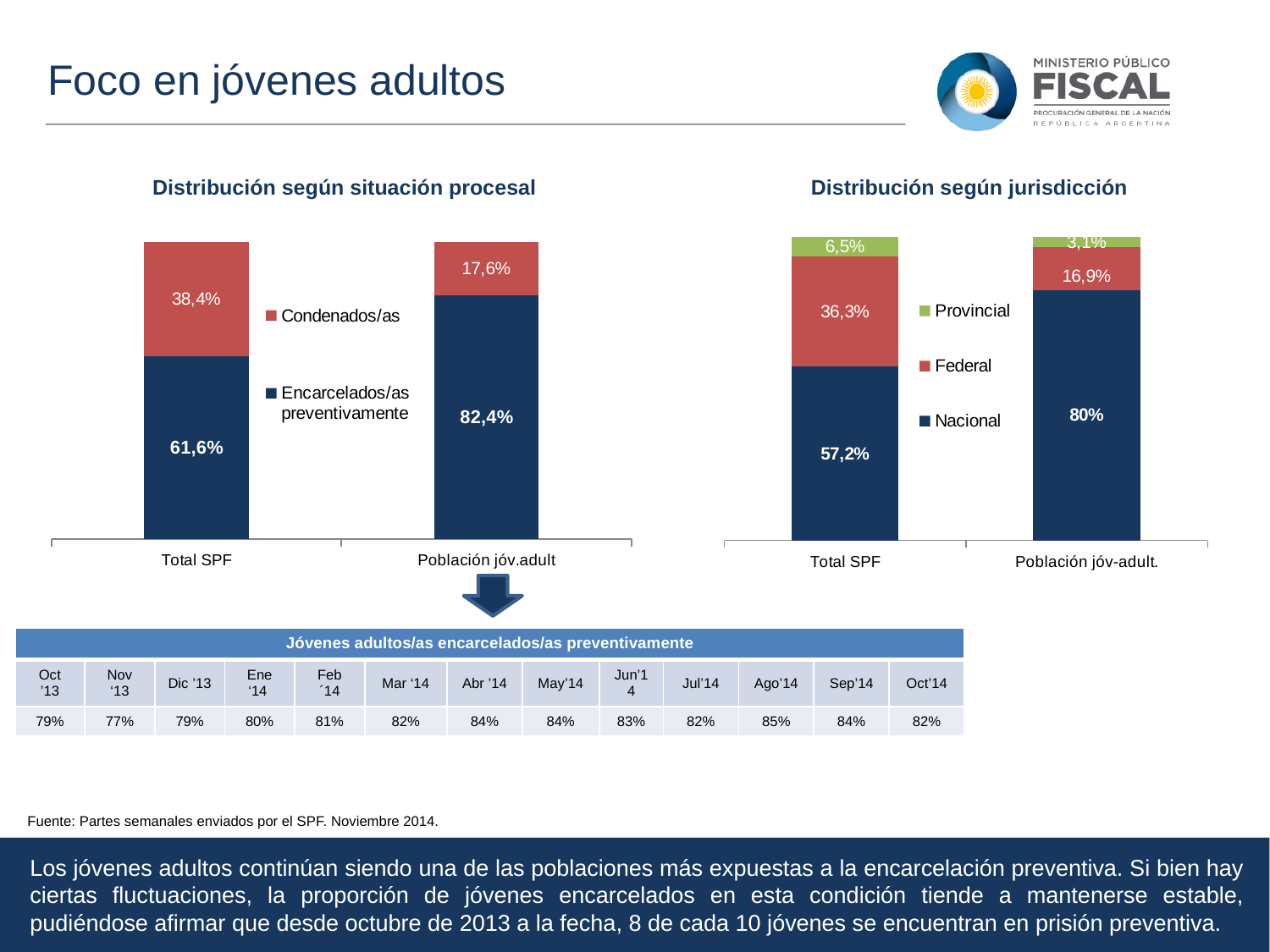
In the chart 'Distribución según situación procesal', what is the value for Encarcelados/as preventivamente in the Total SPF bar? 61,6% In the chart 'Distribución según jurisdicción', what is the value for Federal in the Total SPF bar? 36,3% In the chart 'Distribución según jurisdicción', what is the value for Nacional in the Población jóv-adult. bar? 80% In the chart 'Distribución según situación procesal', which category has the higher Condenados/as value? Total SPF How many series does the legend of the chart 'Distribución según jurisdicción' list? 3 In the chart 'Distribución según situación procesal', what is the difference between the Encarcelados/as preventivamente values for Población jóv.adult and Total SPF? 20,8 percentage points In the chart 'Distribución según situación procesal', what is the value for Condenados/as in the Población jóv.adult bar? 17,6% In the chart 'Distribución según jurisdicción', which category has the larger Federal value, Total SPF or Población jóv-adult.? Total SPF How many series does the legend of the chart 'Distribución según situación procesal' list? 2 In the chart 'Distribución según jurisdicción', what is the total of the Total SPF bar? 100% In the chart 'Distribución según jurisdicción', what is the value for Provincial in the Población jóv-adult. bar? 3,1% What kind of chart is 'Distribución según jurisdicción'? Stacked bar chart